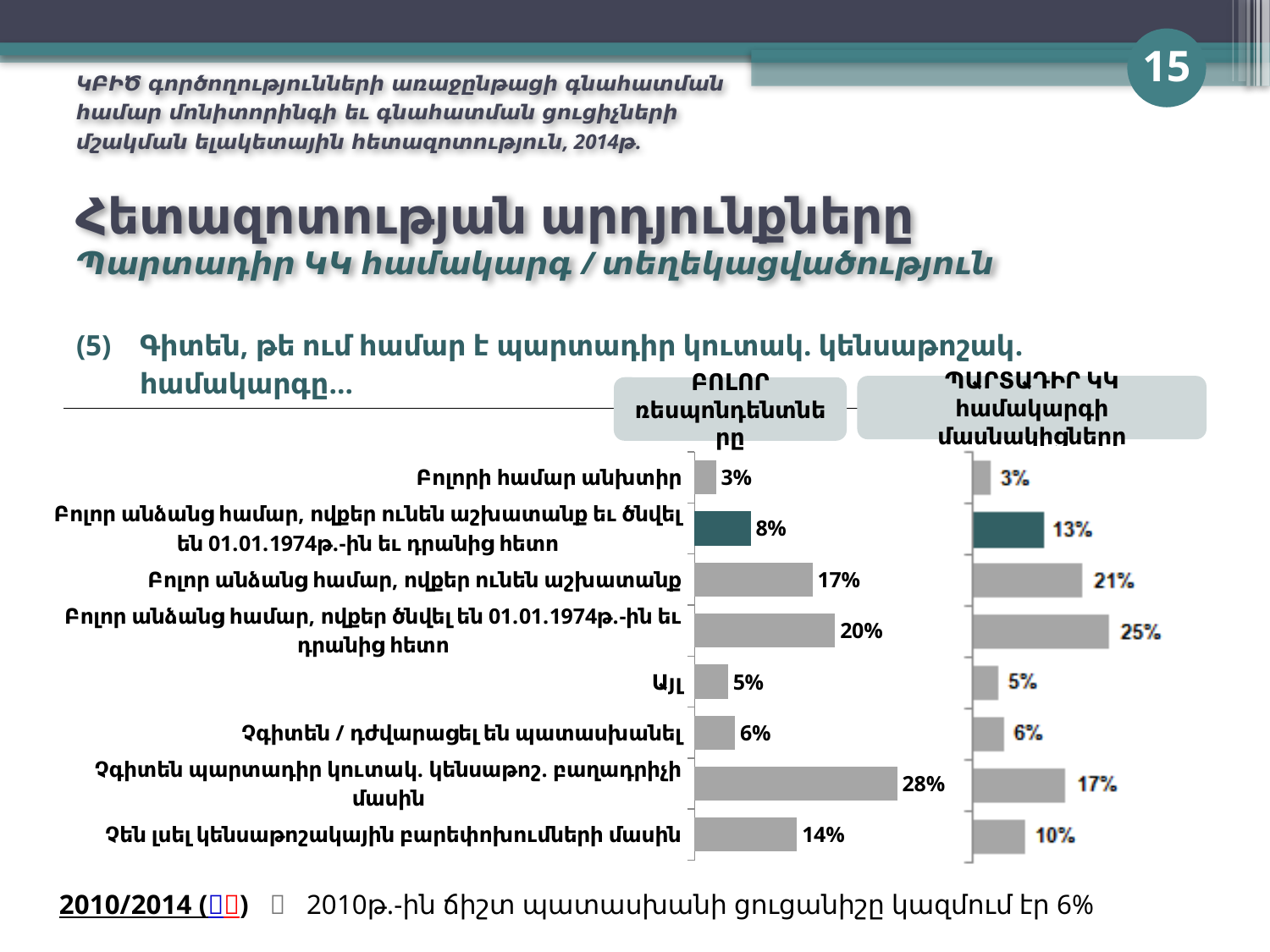
In the right chart (ՊԱՐՏԱԴԻՐ ԿԿ համակարգի մասնակիցները), which category has the lowest value? Բոլորի համար անխտիր What is the difference between the left chart's and the right chart's values for "Չգիտեն պարտադիր կուտակ. կենսաթոշ. բաղադրիչի մասին"? 11% For "Բոլոր անձանց համար, ովքեր ունեն աշխատանք", which chart shows the larger value, the left (ԲՈԼՈՐ ռեսպոնդենտները) or the right (ՊԱՐՏԱԴԻՐ ԿԿ համակարգի մասնակիցները)? the right chart (ՊԱՐՏԱԴԻՐ ԿԿ համակարգի մասնակիցները) In the left chart (ԲՈԼՈՐ ռեսպոնդենտները), what is the value for "Չեն լսել կենսաթոշակային բարեփոխումների մասին"? 14% In the left chart (ԲՈԼՈՐ ռեսպոնդենտները), what is the value for "Բոլորի համար անխտիր"? 3% In the right chart (ՊԱՐՏԱԴԻՐ ԿԿ համակարգի մասնակիցները), which category has the highest value? Բոլոր անձանց համար, ովքեր ծնվել են 01.01.1974թ.-ին և դրանից հետո In the left chart (ԲՈԼՈՐ ռեսպոնդենտները), which category has the highest value? Չգիտեն պարտադիր կուտակ. կենսաթոշ. բաղադրիչի մասին How many categories are shown in the left chart (ԲՈԼՈՐ ռեսպոնդենտները)? 8 In the left chart (ԲՈԼՈՐ ռեսպոնդենտները), what is the difference between "Բոլոր անձանց համար, ովքեր ծնվել են 01.01.1974թ.-ին և դրանից հետո" and "Բոլոր անձանց համար, ովքեր ունեն աշխատանք"? 3% In the right chart (ՊԱՐՏԱԴԻՐ ԿԿ համակարգի մասնակիցները), what is the value for "Չեն լսել կենսաթոշակային բարեփոխումների մասին"? 10% What type of chart is used on this slide? bar chart In the right chart (ՊԱՐՏԱԴԻՐ ԿԿ համակարգի մասնակիցները), what is the value for "Բոլոր անձանց համար, ովքեր ունեն աշխատանք և ծնվել են 01.01.1974թ.-ին և դրանից հետո"? 13%